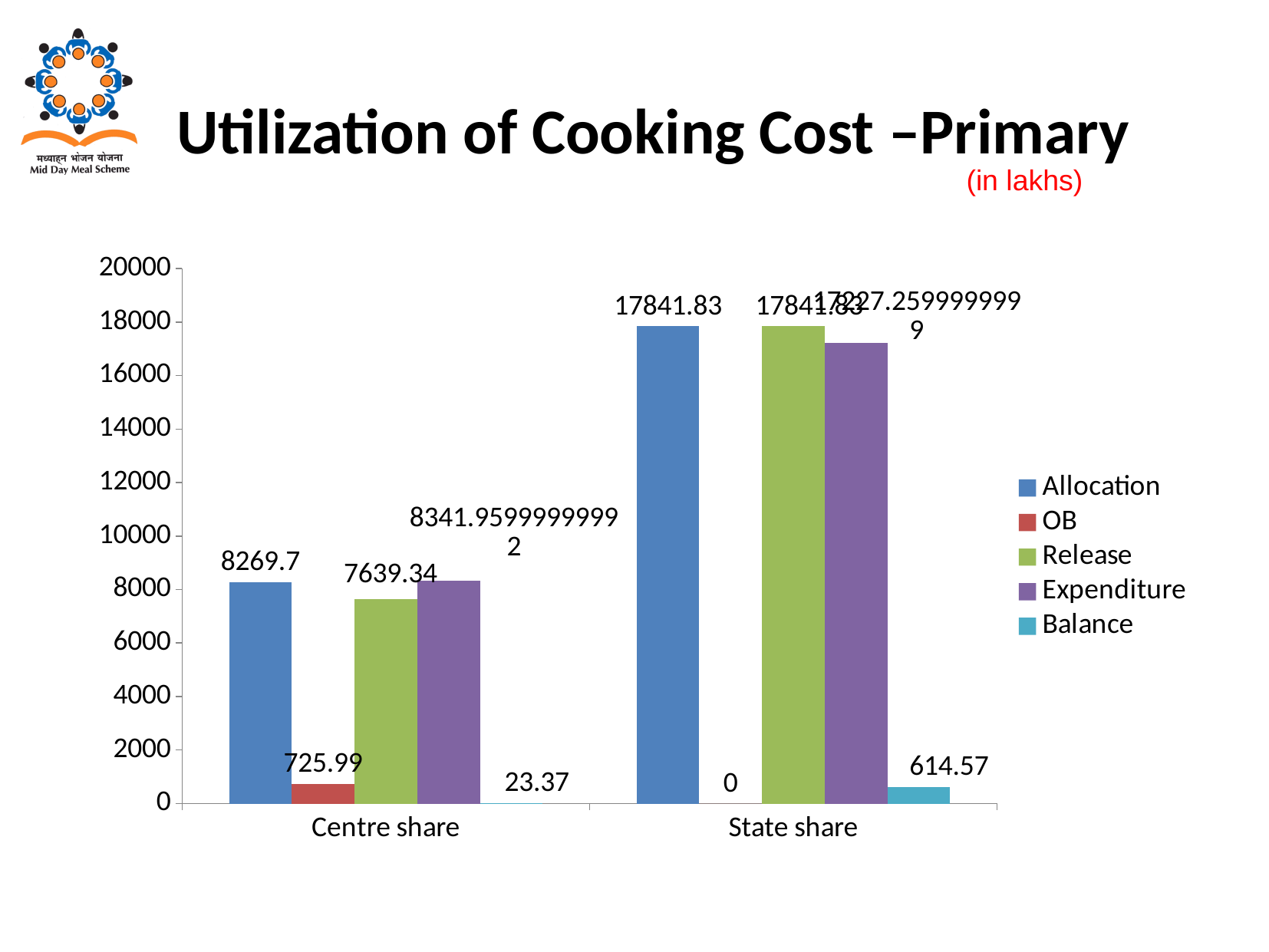
What kind of chart is shown on the slide? bar chart What is the Balance value for State share? 614.57 What is the difference between the Allocation for State share and the Allocation for Centre share? 9572.13 How many series does the legend list? 5 What is the OB value for Centre share? 725.99 What is the Allocation value for Centre share? 8269.7 What is the Balance value for Centre share? 23.37 What is the Release value for Centre share? 7639.34 What is the OB value for State share? 0 Is the Expenditure value for State share greater or less than 16000? greater What is the Allocation value for State share? 17841.83 How many categories are shown on the x axis? 2